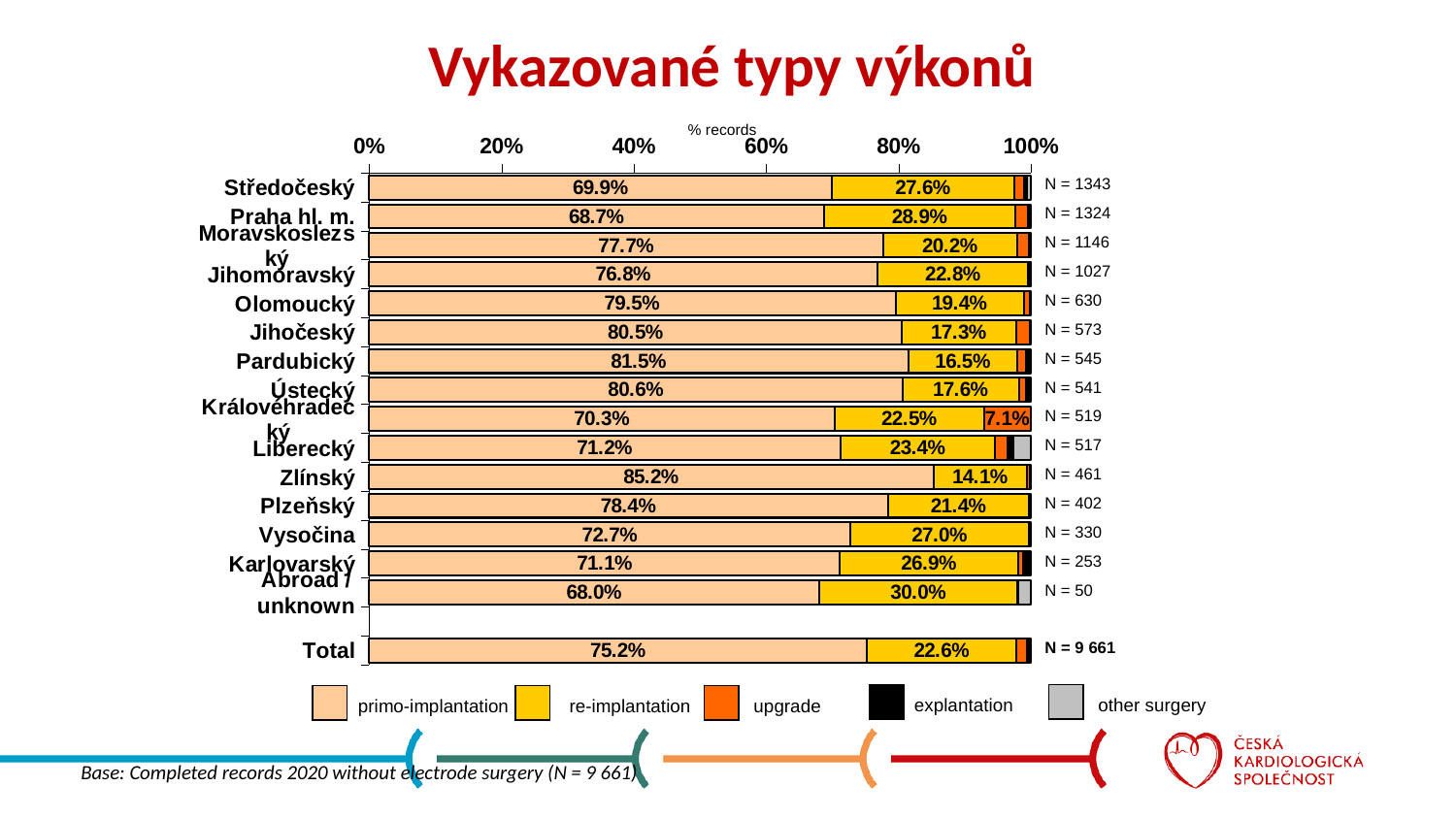
What is the label of the x axis? % records What is the N value shown for Středočeský? N = 1343 What is the re-implantation share for Praha hl. m.? 28.9% Which region has the lowest re-implantation share? Zlínský What type of chart is shown on the slide? stacked bar chart What is the primo-implantation share for Zlínský? 85.2% What is the primo-implantation share for the Total row? 75.2% What is the difference between the primo-implantation shares of Zlínský and Abroad / unknown? 17.2% How many series does the legend list? 5 What is the upgrade share shown for Královéhradecký? 7.1% Which region has the highest primo-implantation share? Zlínský Which has a larger re-implantation share, Vysočina or Karlovarský? Vysočina